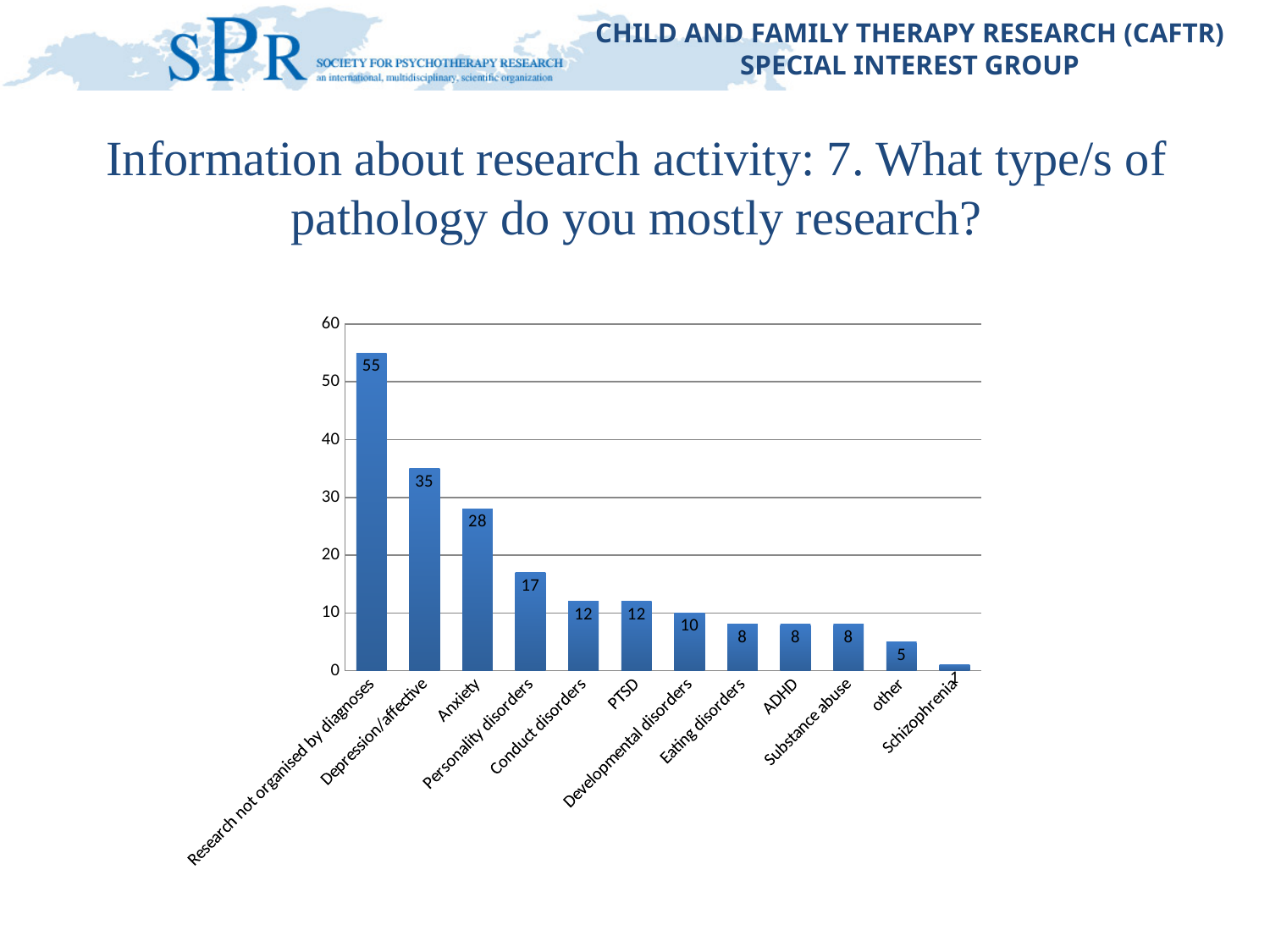
What is the value for Depression/affective? 35 What is the value for Developmental disorders? 10 Is the value for Conduct disorders greater or less than 20? less What is the difference between the values for PTSD and other? 7 Which category has the highest value? Research not organised by diagnoses Which is larger, the value for Anxiety or the value for Personality disorders? Anxiety What is the difference between the values for Research not organised by diagnoses and Depression/affective? 20 What type of chart is shown on the slide? bar chart What is the value for Anxiety? 28 Which category has the lowest value? Schizophrenia What is the value for Personality disorders? 17 How many categories are shown on the x axis? 12